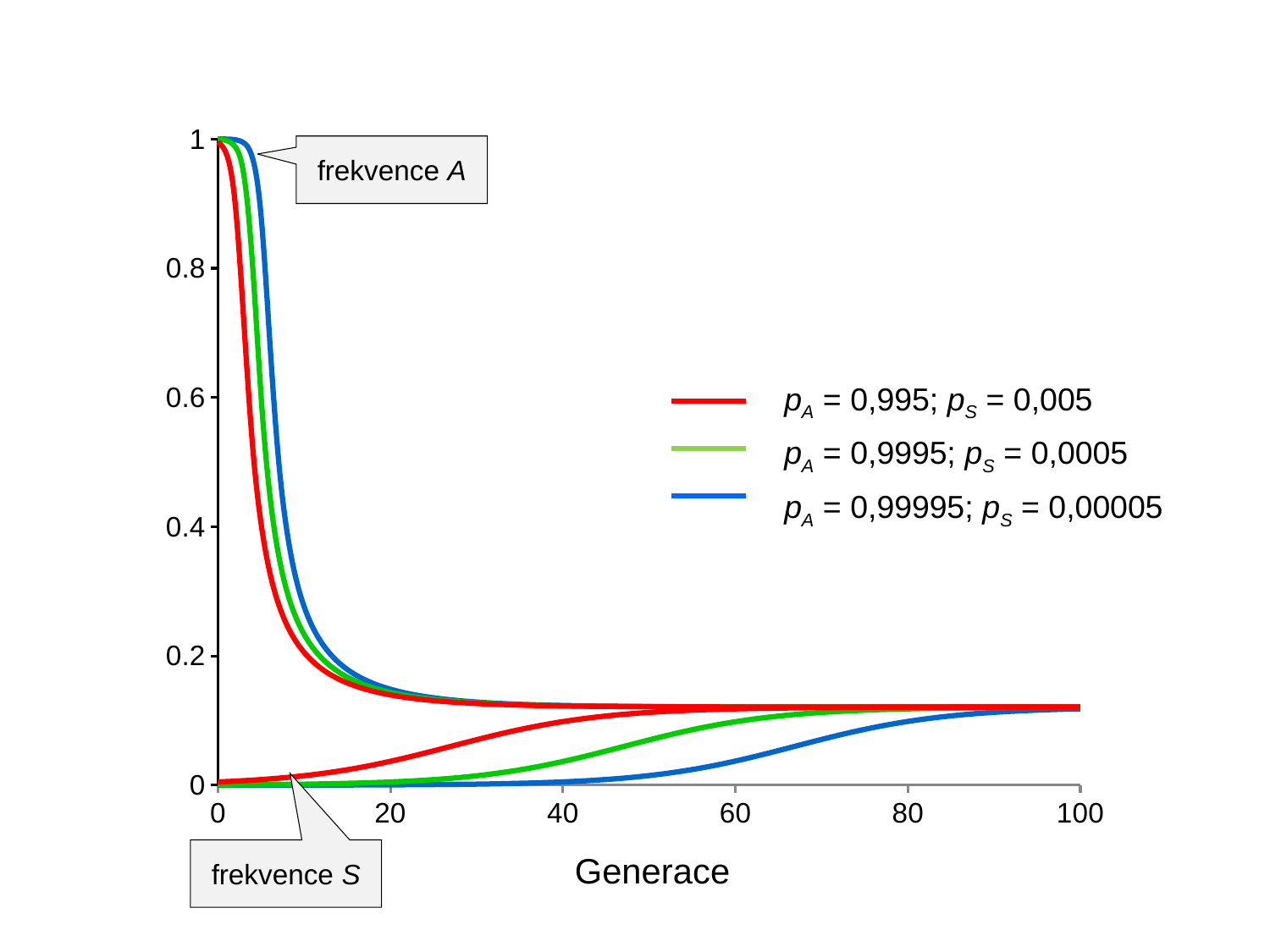
What kind of chart is shown on the slide? line chart What is the legend entry for the blue series? p_A = 0,99995; p_S = 0,00005 How many series does the legend list? 3 What is the value of 'frekvence A' at generation 0? 1 Do the 'frekvence A' curves rise or fall as the generation number increases? fall What is the label of the x axis? Generace What is the value of 'frekvence S' at generation 0? 0 At generation 10, which 'frekvence A' curve is higher, the red one or the blue one? blue Is the blue 'frekvence S' curve at generation 40 greater or less than 0.2? less At generation 60, which 'frekvence S' curve is higher, the red one or the blue one? red Do the 'frekvence S' curves rise or fall as the generation number increases? rise Is the red 'frekvence A' curve at generation 20 greater or less than 0.2? less